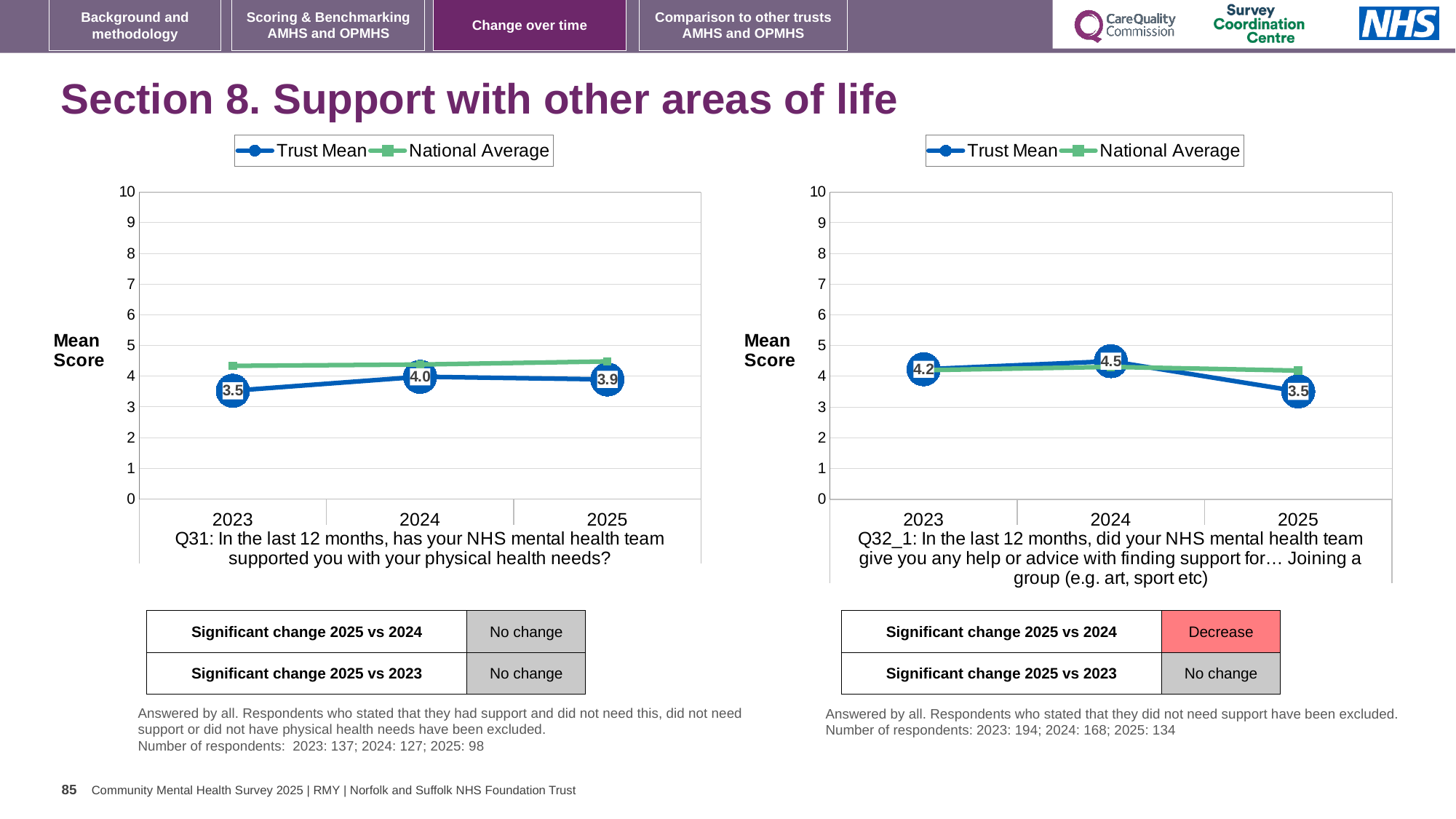
How many series does the legend of the right chart (Q32_1) list? 2 What kind of chart is the left chart (Q31)? line chart In the left chart (Q31), what is the Trust Mean for 2025? 3.9 In the right chart (Q32_1), what is the difference between the Trust Mean for 2024 and 2025? 1.0 In the right chart (Q32_1), what is the Trust Mean for 2025? 3.5 In the right chart (Q32_1), what is the Trust Mean for 2024? 4.5 In the right chart (Q32_1), does the Trust Mean rise or fall from 2024 to 2025? fall In the left chart (Q31), is the Trust Mean for 2023 higher or lower than the National Average for 2023? lower In the left chart (Q31), what is the Trust Mean for 2023? 3.5 In the left chart (Q31), is the National Average for 2025 greater or less than 4? greater In the right chart (Q32_1), which year has the lowest Trust Mean? 2025 In the left chart (Q31), which year has the highest Trust Mean? 2024